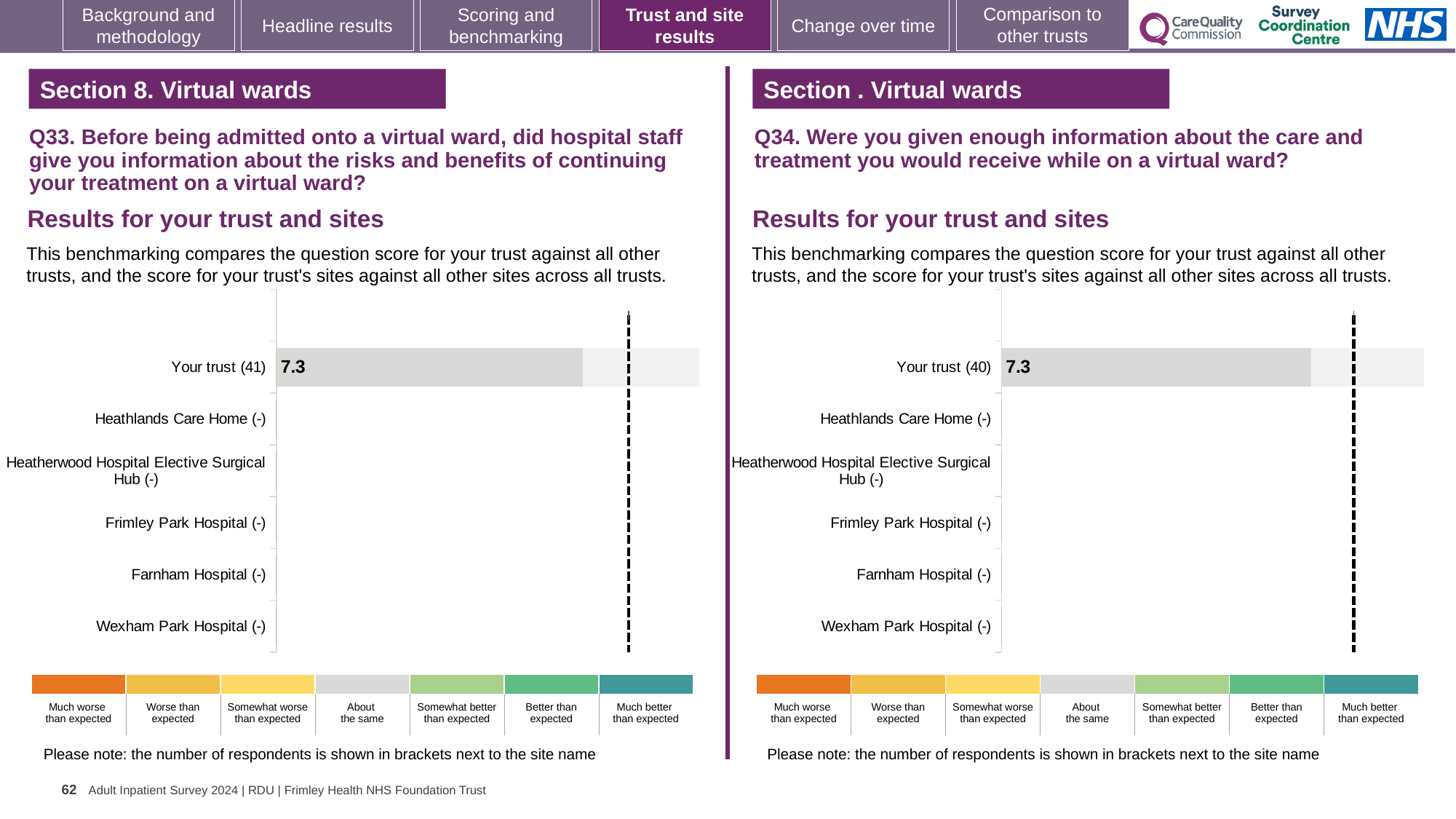
Is the Your trust score in the Q33 chart on the left larger than, smaller than, or equal to the Your trust score in the Q34 chart on the right? Equal How many benchmark bands does the colour key below the Q34 chart on the right list? 7 What kind of chart is the Q33 chart on the left? Bar chart How many categories (rows) are listed on the y axis of the Q33 chart on the left? 6 In the Q34 chart on the right, which category is the only one with a plotted bar? Your trust (40) What is the difference between the Your trust score in the Q33 chart and the Your trust score in the Q34 chart? 0 How many categories (rows) are listed on the y axis of the Q34 chart on the right? 6 In the Q33 chart on the left, how many respondents are shown in brackets for Your trust? 41 In the Q33 chart on the left, what is the score for Your trust? 7.3 In the Q33 chart on the left, which category is the only one with a plotted bar? Your trust (41) In the Q34 chart on the right, what is the score for Your trust? 7.3 In the Q34 chart on the right, how many respondents are shown in brackets for Your trust? 40